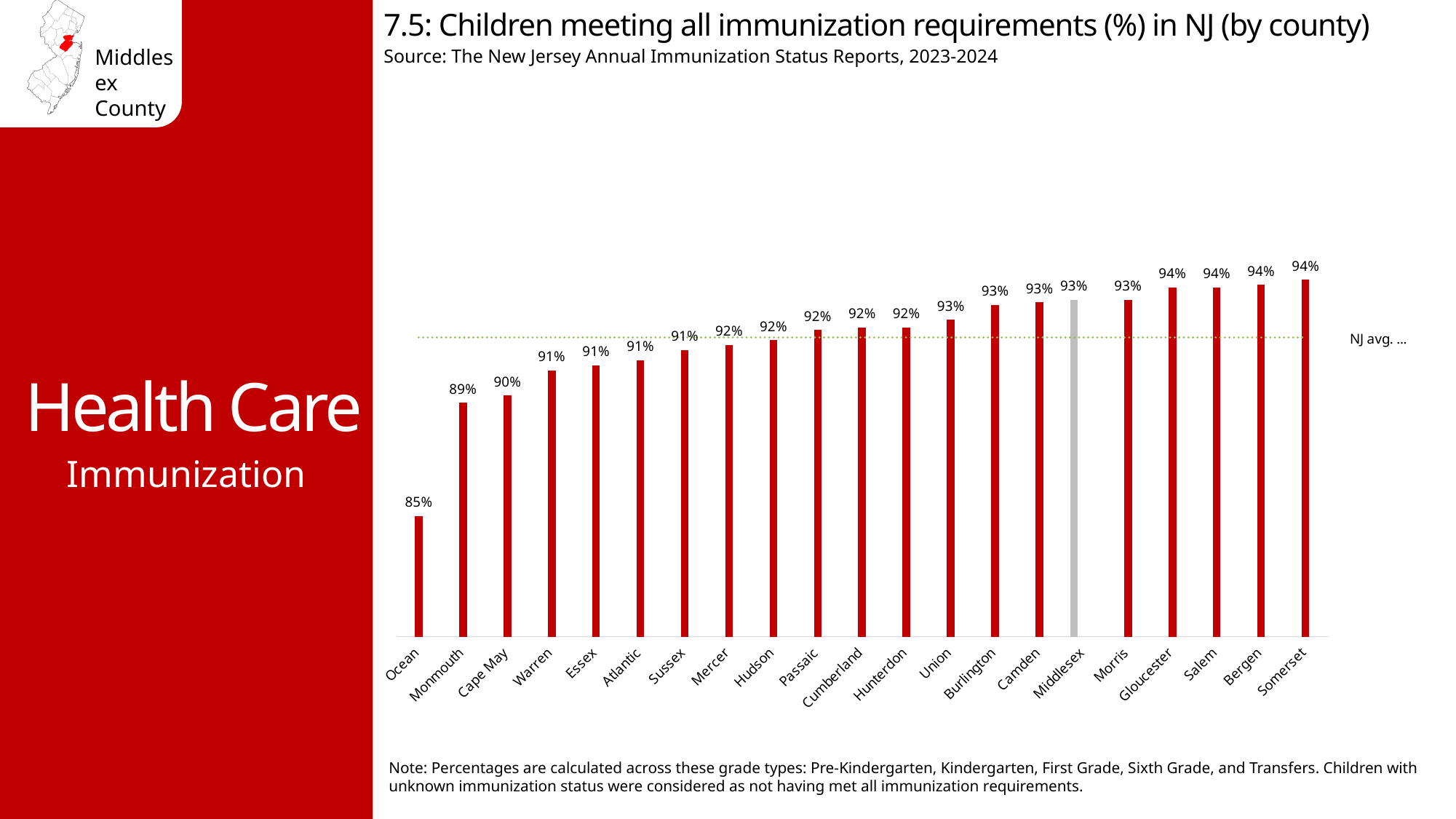
What is the value shown for Monmouth? 89% What is the value shown for Middlesex County? 93% What is the difference in percentage points between Middlesex and Monmouth? 4 percentage points What percentage of children in Ocean County meet all immunization requirements? 85% What is the value shown for Cape May? 90% Do the values generally rise or fall from left to right across the counties? Rise What is the difference in percentage points between Somerset and Ocean? 9 percentage points How many counties are shown in the chart? 21 What kind of chart is shown on the slide? Bar chart Which has a higher value, Cape May or Somerset? Somerset Which county has the lowest percentage of children meeting all immunization requirements? Ocean Which has a higher value, Ocean or Monmouth? Monmouth